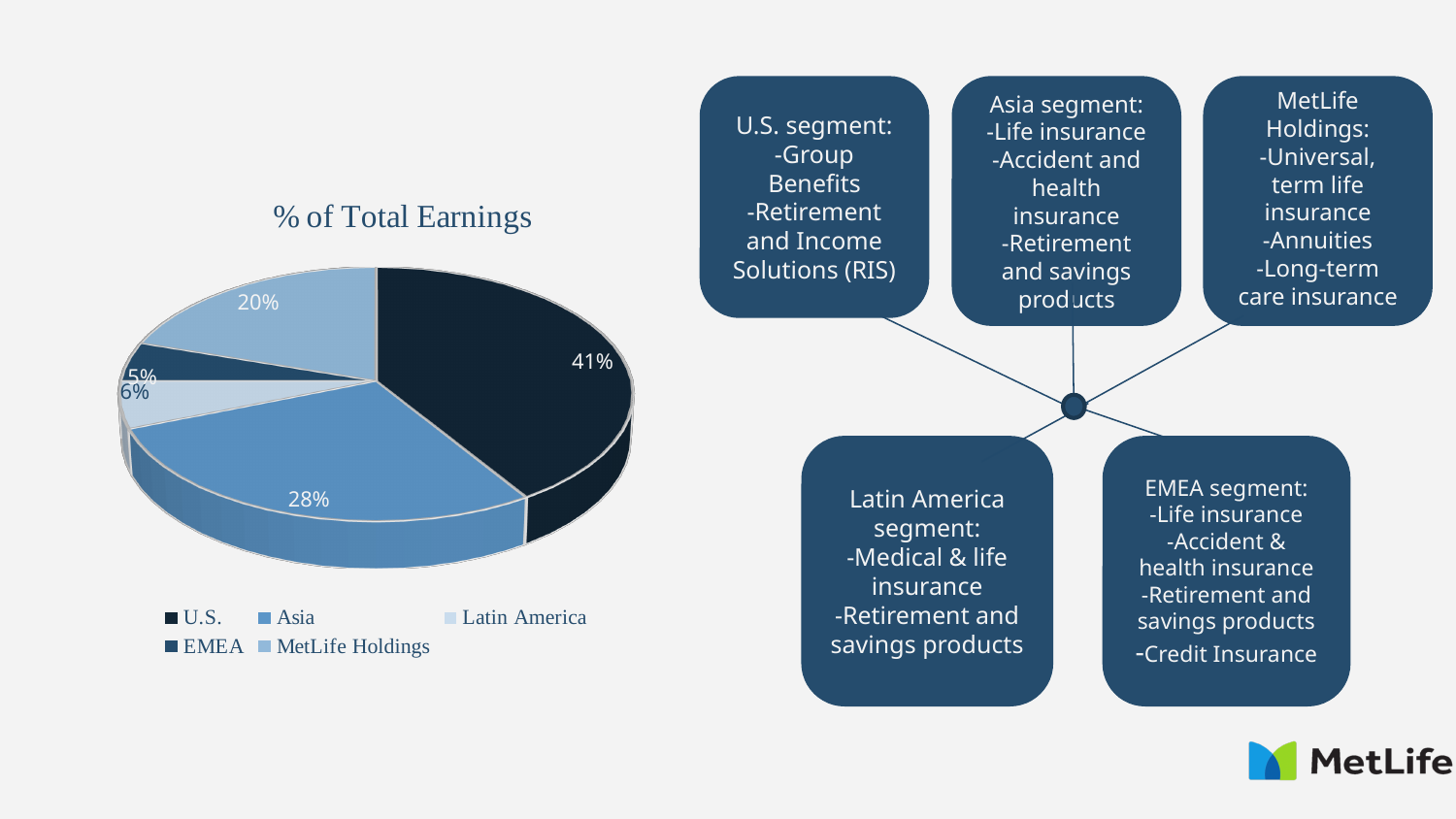
What is the title of the pie chart? % of Total Earnings What kind of chart is shown on the slide? pie chart What percentage of total earnings does Latin America account for? 6% Which segment has the smallest share of total earnings? EMEA Which segment has the largest share of total earnings? U.S. What percentage of total earnings does Asia account for? 28% What percentage of total earnings does MetLife Holdings account for? 20% What percentage of total earnings does EMEA account for? 5% How many segments does the legend of the pie chart list? 5 Which has a larger share of total earnings, MetLife Holdings or Asia? Asia What percentage of total earnings does the U.S. segment account for? 41% How many percentage points larger is the U.S. share than the Asia share? 13